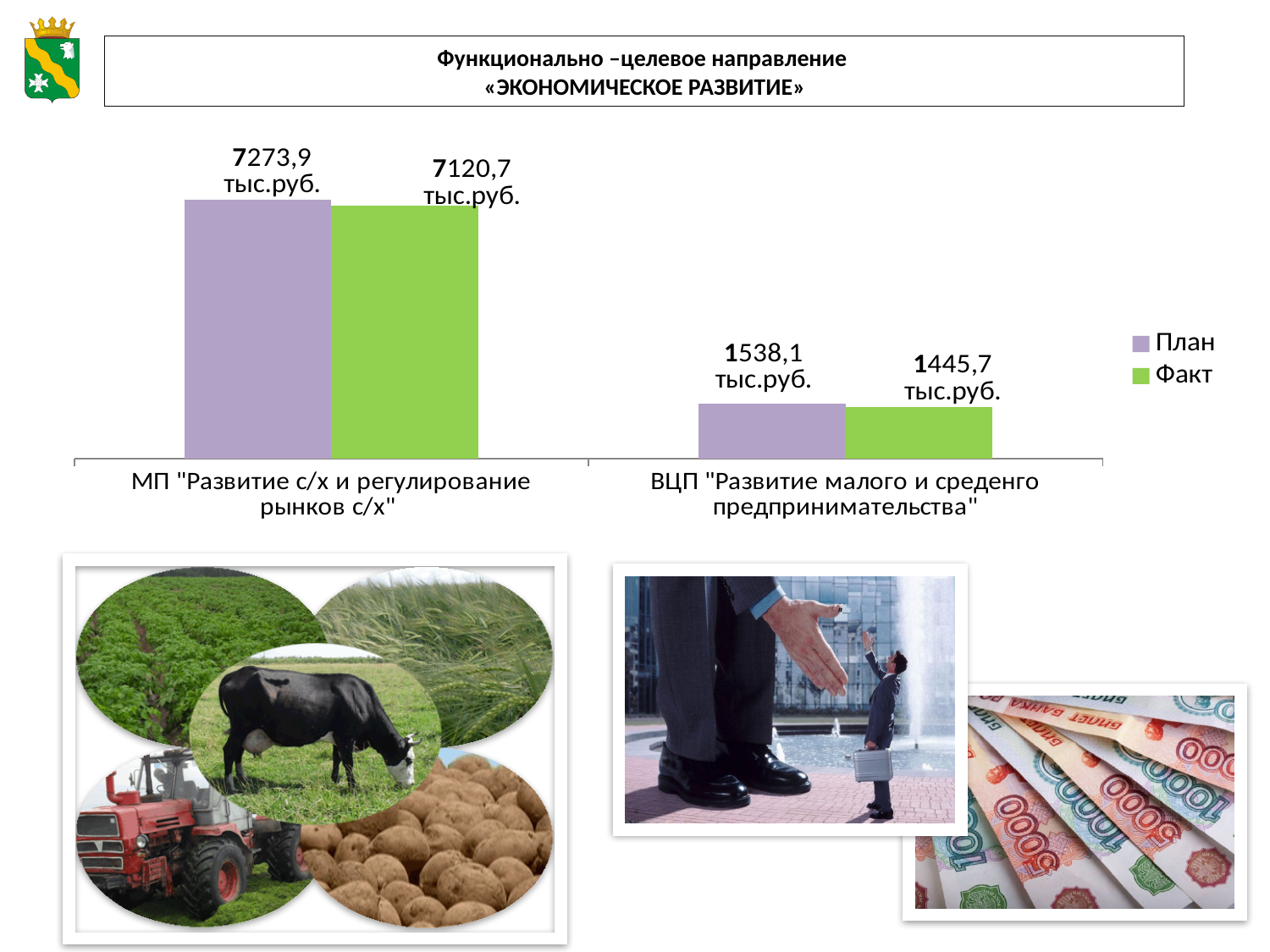
What is the Факт value for ВЦП "Развитие малого и среденго предпринимательства"? 1445,7 тыс.руб. For ВЦП "Развитие малого и среденго предпринимательства", which is larger, План or Факт? План How many categories are shown on the x axis of the chart? 2 How many series does the chart legend list? 2 Which category has the lowest Факт value? ВЦП "Развитие малого и среденго предпринимательства" What is the difference between the План and Факт values for ВЦП "Развитие малого и среденго предпринимательства"? 92,4 тыс.руб. What is the Факт value for МП "Развитие с/х и регулирование рынков с/х"? 7120,7 тыс.руб. What kind of chart is shown on the slide? Bar chart What is the difference between the План and Факт values for МП "Развитие с/х и регулирование рынков с/х"? 153,2 тыс.руб. What is the План value for МП "Развитие с/х и регулирование рынков с/х"? 7273,9 тыс.руб. What is the План value for ВЦП "Развитие малого и среденго предпринимательства"? 1538,1 тыс.руб. Which category has the highest План value? МП "Развитие с/х и регулирование рынков с/х"